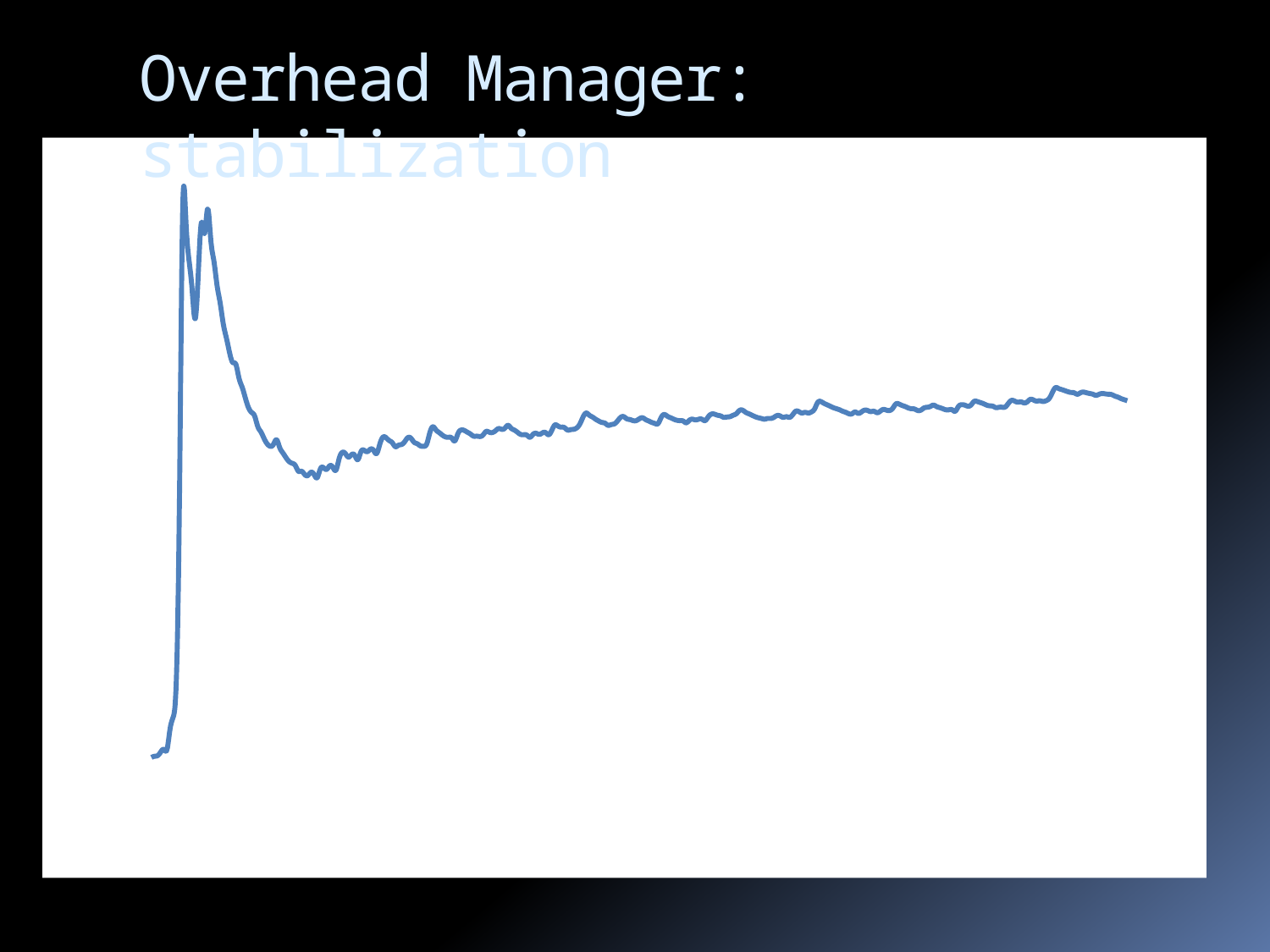
What is the title of the slide containing the chart? Overhead Manager: stabilization What colour is the plotted line? blue Over the right half of the chart, is the line roughly flat or does it swing sharply? roughly flat How many lines are plotted on the chart? 1 What kind of chart is shown on the slide? line chart Does the line reach its highest point near the left or the right side of the chart? left At the very start of the chart, does the line rise or fall? rise Immediately after its sharp peak near the left, does the line rise or fall? fall